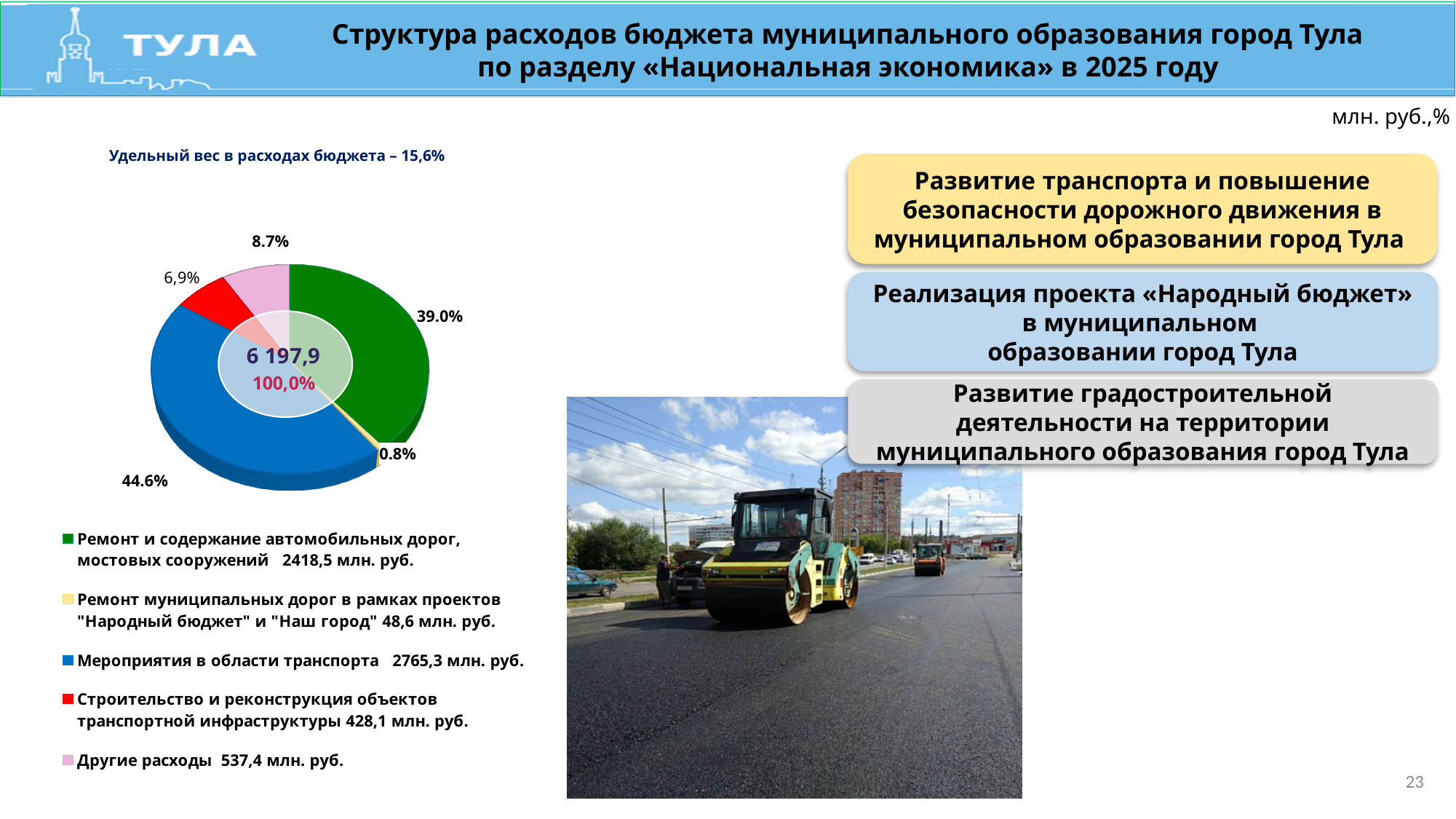
What kind of chart is shown on the slide? pie chart What total value is shown in the centre of the pie chart? 6 197,9 Which category has the largest slice of the pie? Мероприятия в области транспорта What share of the pie does "Ремонт и содержание автомобильных дорог, мостовых сооружений" take? 39.0% What share of the pie does "Строительство и реконструкция объектов транспортной инфраструктуры" take? 6,9% Which category has the smallest slice of the pie? Ремонт муниципальных дорог в рамках проектов "Народный бюджет" и "Наш город" What share of the pie does "Ремонт муниципальных дорог в рамках проектов "Народный бюджет" и "Наш город"" take? 0.8% How many slices does the pie chart have? 5 Which is larger: the share for "Другие расходы" or the share for "Строительство и реконструкция объектов транспортной инфраструктуры"? Другие расходы What is the value in млн. руб. for "Мероприятия в области транспорта" shown in the legend? 2765,3 млн. руб.